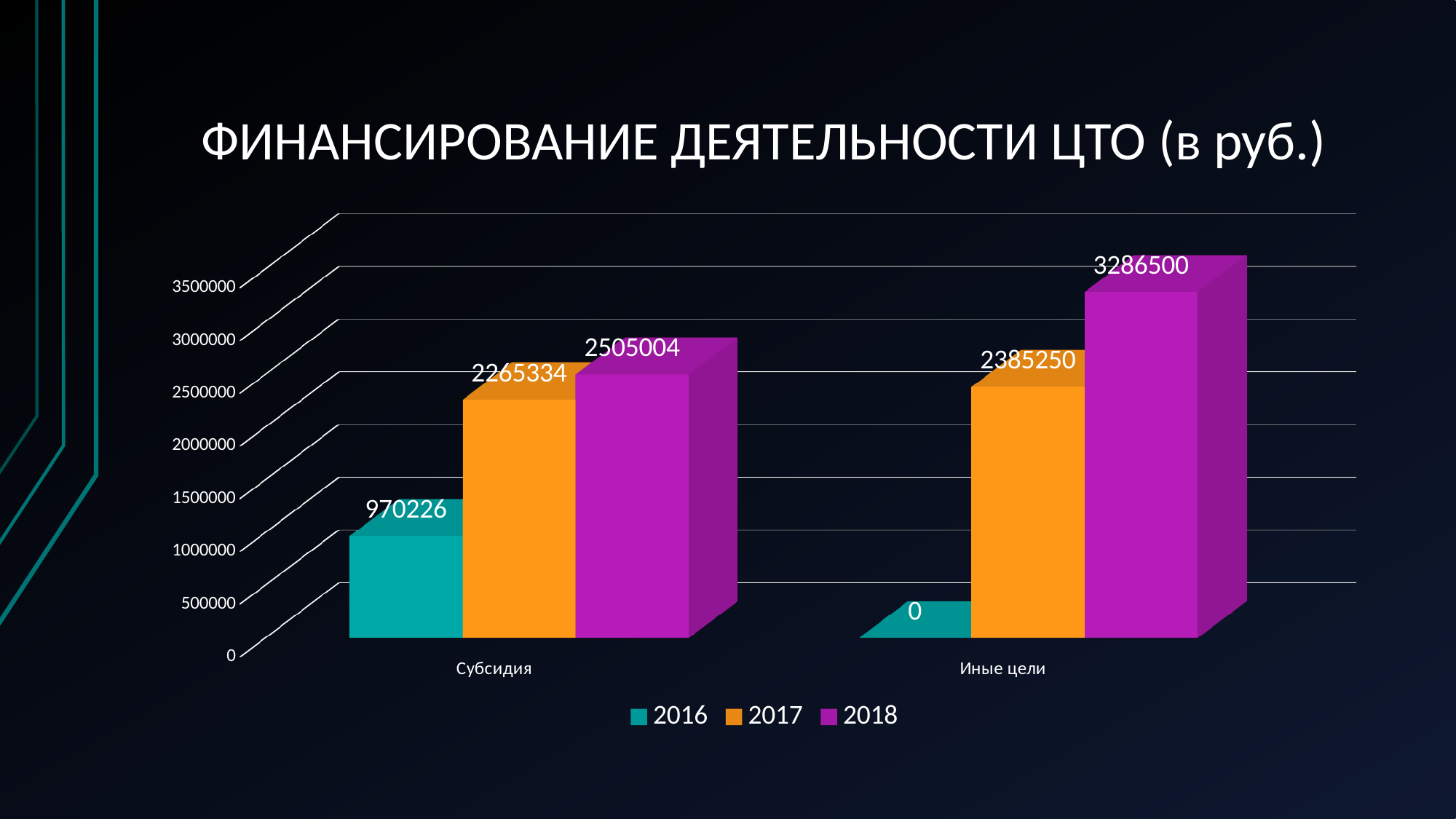
What is the title of the chart? ФИНАНСИРОВАНИЕ ДЕЯТЕЛЬНОСТИ ЦТО (в руб.) What is the value for 2018 in the Иные цели category? 3286500 What is the value for 2016 in the Субсидия category? 970226 Which year has the highest value in the Иные цели category? 2018 What is the value for 2016 in the Иные цели category? 0 Which is larger: the 2017 value for Субсидия or the 2017 value for Иные цели? Иные цели Which year has the lowest value in the Субсидия category? 2016 How many categories are shown on the x axis? 2 What kind of chart is shown on the slide? Bar chart What is the value for 2017 in the Субсидия category? 2265334 How many series does the legend list? 3 What is the difference between the 2018 and 2017 values in the Субсидия category? 239670